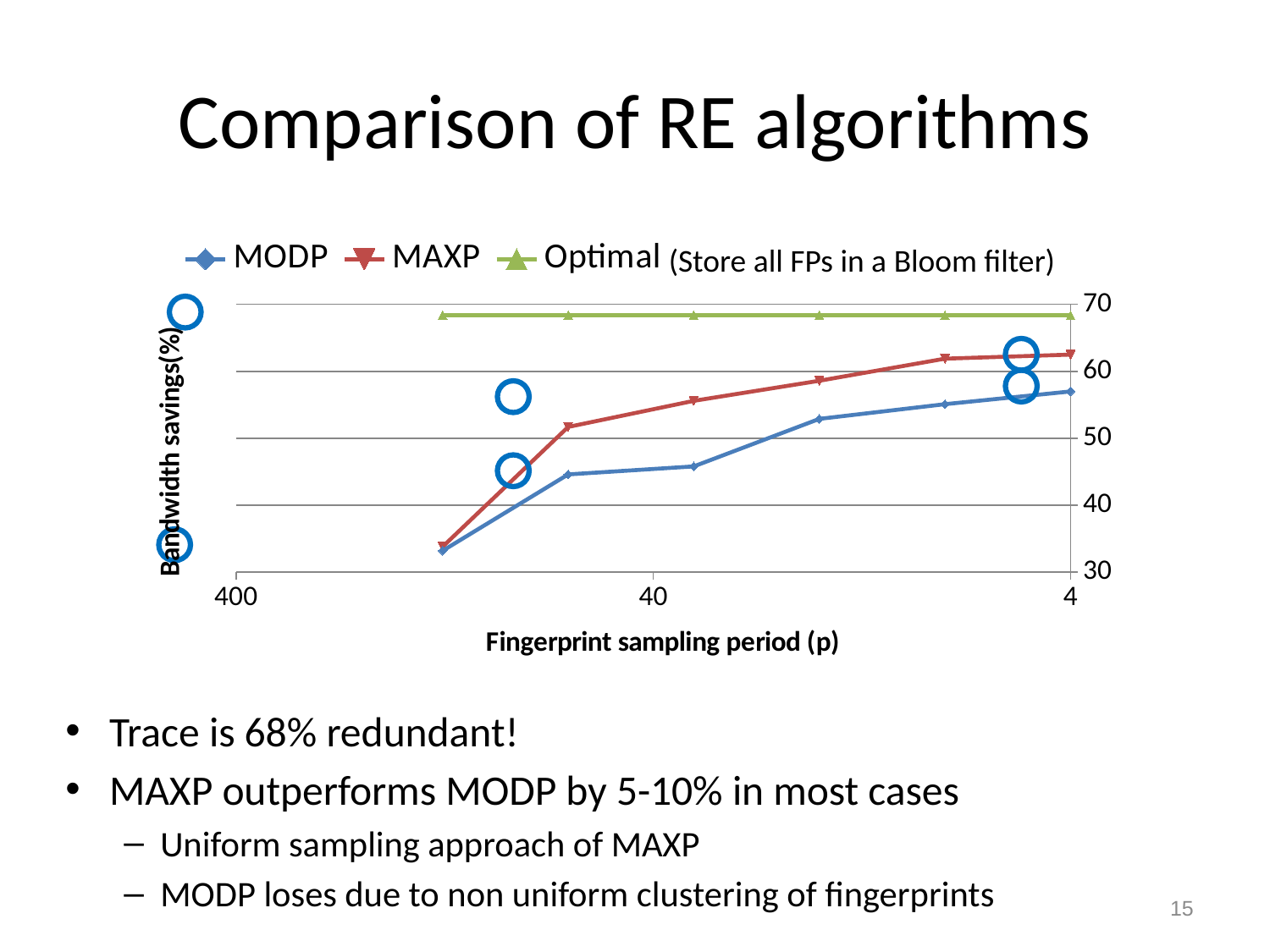
How many series does the legend list? 3 Which series has the lowest bandwidth savings at a fingerprint sampling period of 4? MODP Is the bandwidth savings value for Optimal greater or less than 60? greater Is the bandwidth savings value for MODP at a sampling period of 4 greater or less than 60? less At a fingerprint sampling period of 4, which series is higher, MAXP or MODP? MAXP What is the title of the x axis? Fingerprint sampling period (p) Do the MAXP bandwidth savings rise or fall moving from left to right along the x axis? rise How many data points are plotted for the MODP series? 6 What kind of chart is shown on the slide? line chart What is the title of the y axis? Bandwidth savings(%) Which series has the highest bandwidth savings across the whole chart? Optimal